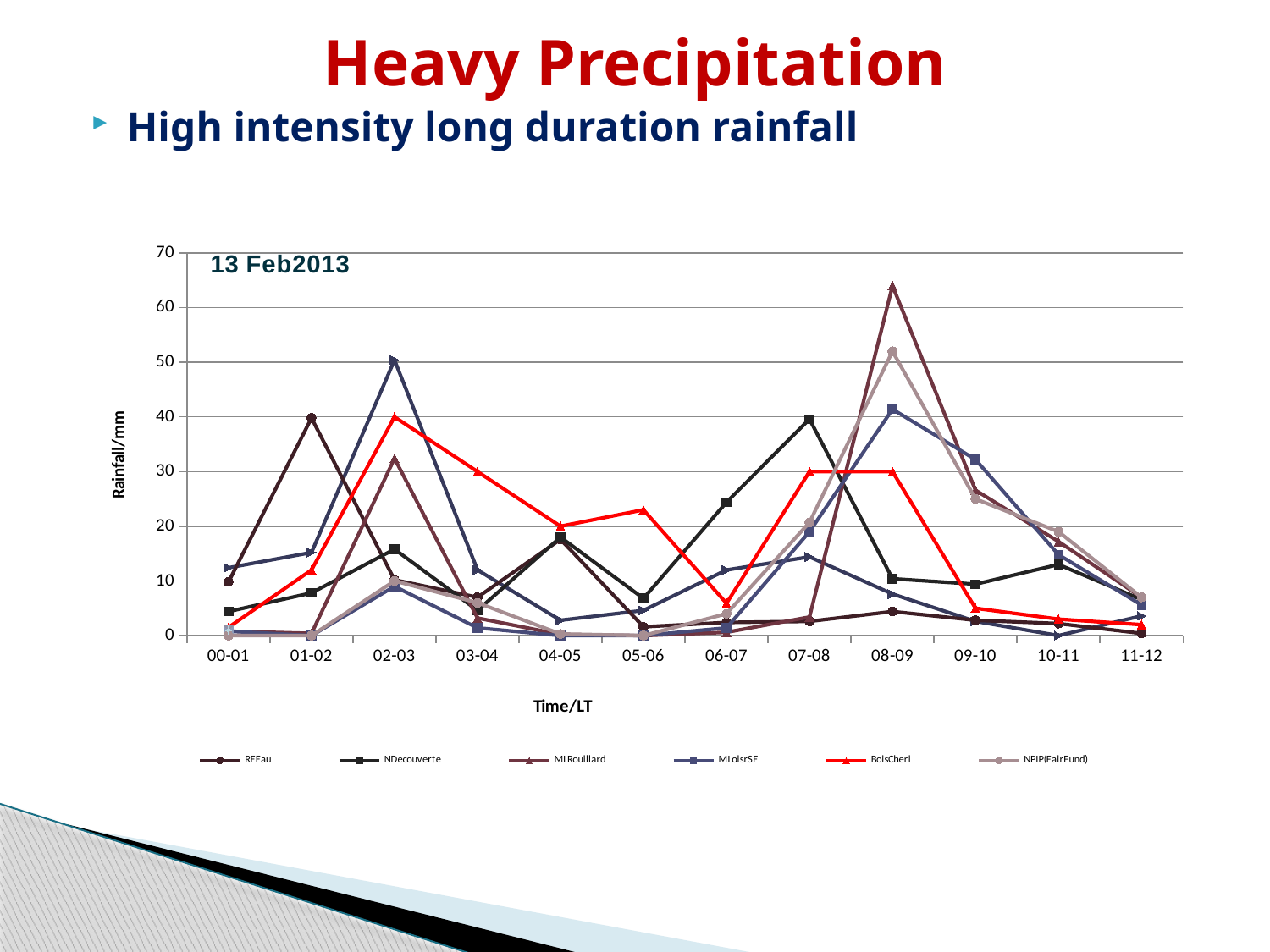
How many time intervals are shown along the x axis? 12 Is the value for MLoisrSE at 02-03 greater or less than 40? less Is the value for NPIP(FairFund) at 08-09 greater or less than 40? greater How many series does the legend list? 6 What is the rainfall value for BoisCheri at 02-03? 40 Is the value for NDecouverte at 07-08 greater or less than 30? greater What is the label of the vertical axis? Rainfall/mm What kind of chart is shown on the slide? line chart What date label is printed inside the chart area? 13 Feb2013 At 01-02, which is larger: REEau or NDecouverte? REEau Which series has the highest rainfall at 08-09? MLRouillard